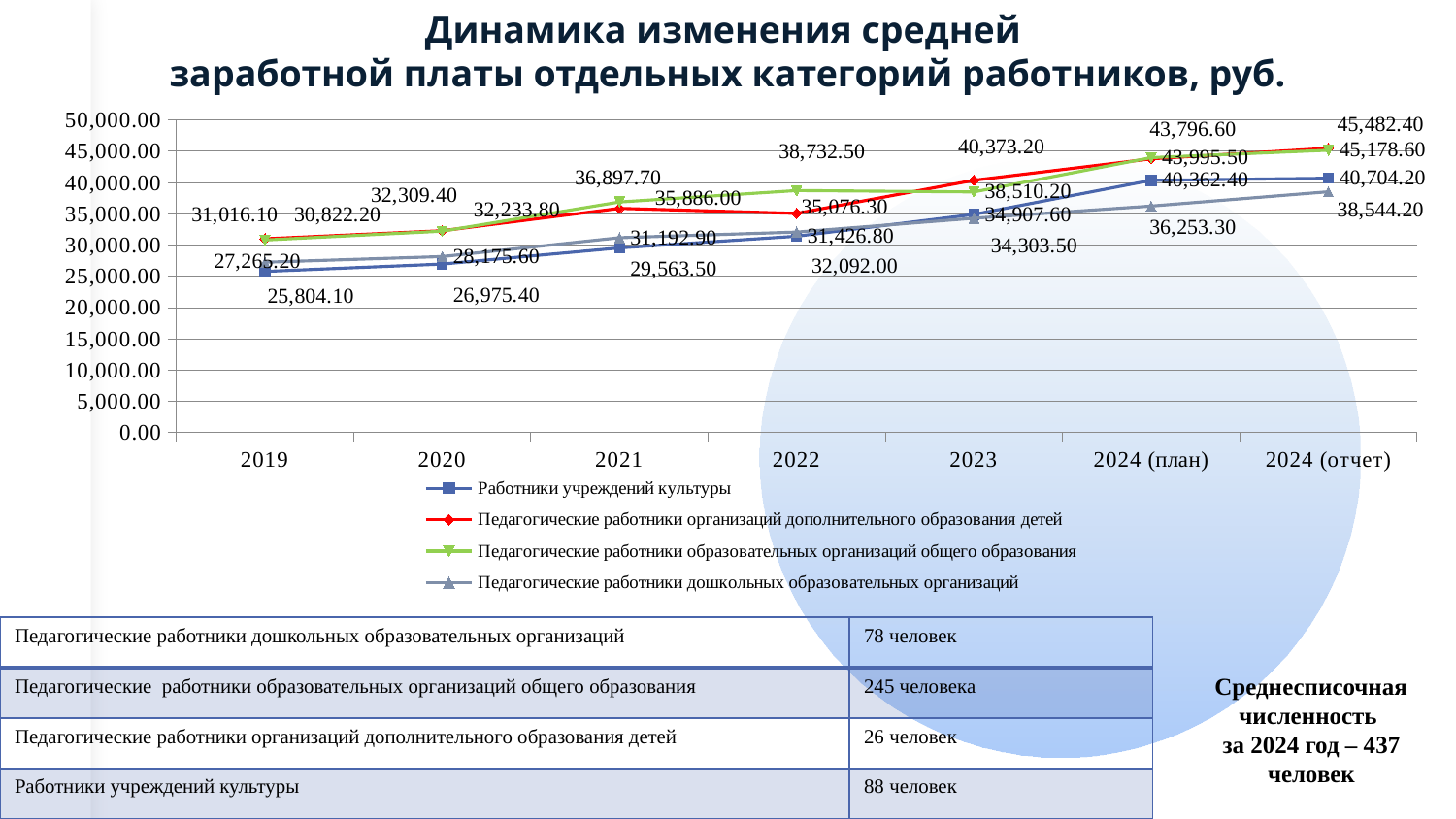
What is the value for Педагогические работники организаций дополнительного образования детей in 2023? 40,373.20 In 2023, which is larger: the value for Педагогические работники организаций дополнительного образования детей or for Педагогические работники образовательных организаций общего образования? Педагогические работники организаций дополнительного образования детей What is the value for Работники учреждений культуры in 2019? 25,804.10 How many series does the legend list? 4 What is the value for Педагогические работники дошкольных образовательных организаций in 2021? 31,192.90 Which series has the highest value in 2022? Педагогические работники образовательных организаций общего образования Which series has the lowest value in 2019? Работники учреждений культуры Do the values for Работники учреждений культуры rise or fall from 2019 to 2024 (отчет)? rise What kind of chart is shown on the slide? line chart What is the difference between the 2024 (отчет) and 2024 (план) values for Работники учреждений культуры? 341.80 What is the value for Педагогические работники образовательных организаций общего образования in 2022? 38,732.50 How many points are there along the x axis? 7